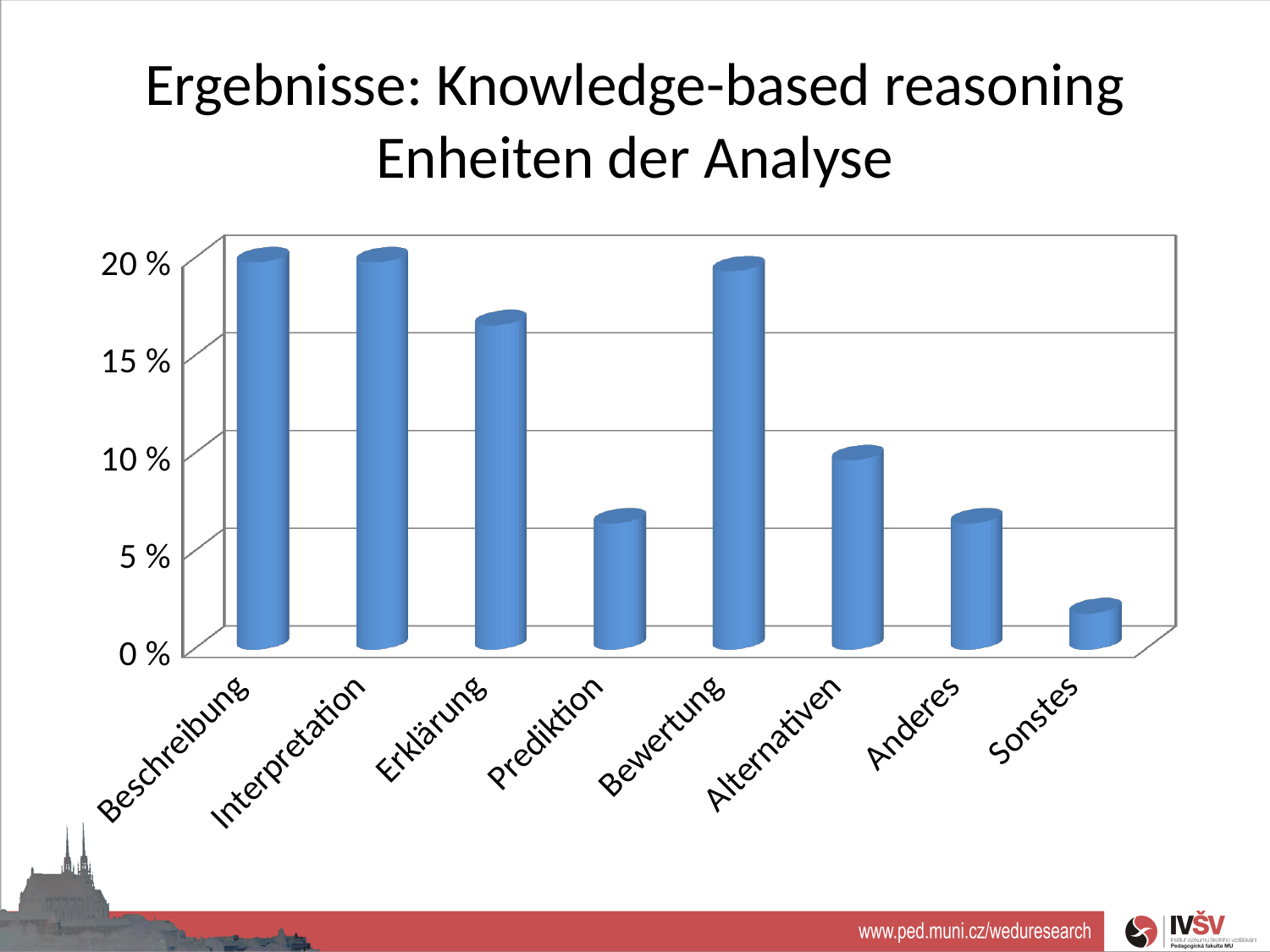
Is the value for Prediktion greater or less than 10 %? less Is the value for Anderes greater or less than 5 %? greater What kind of chart is shown on the slide? bar chart What is the title of the slide containing the chart? Ergebnisse: Knowledge-based reasoning Enheiten der Analyse Which category has the lowest value in the chart? Sonstes Is the value for Erklärung greater or less than 15 %? greater Which has the larger value, Alternativen or Anderes? Alternativen How many categories are shown on the x axis of the chart? 8 Which has the larger value, Bewertung or Alternativen? Bewertung Which has the larger value, Erklärung or Prediktion? Erklärung